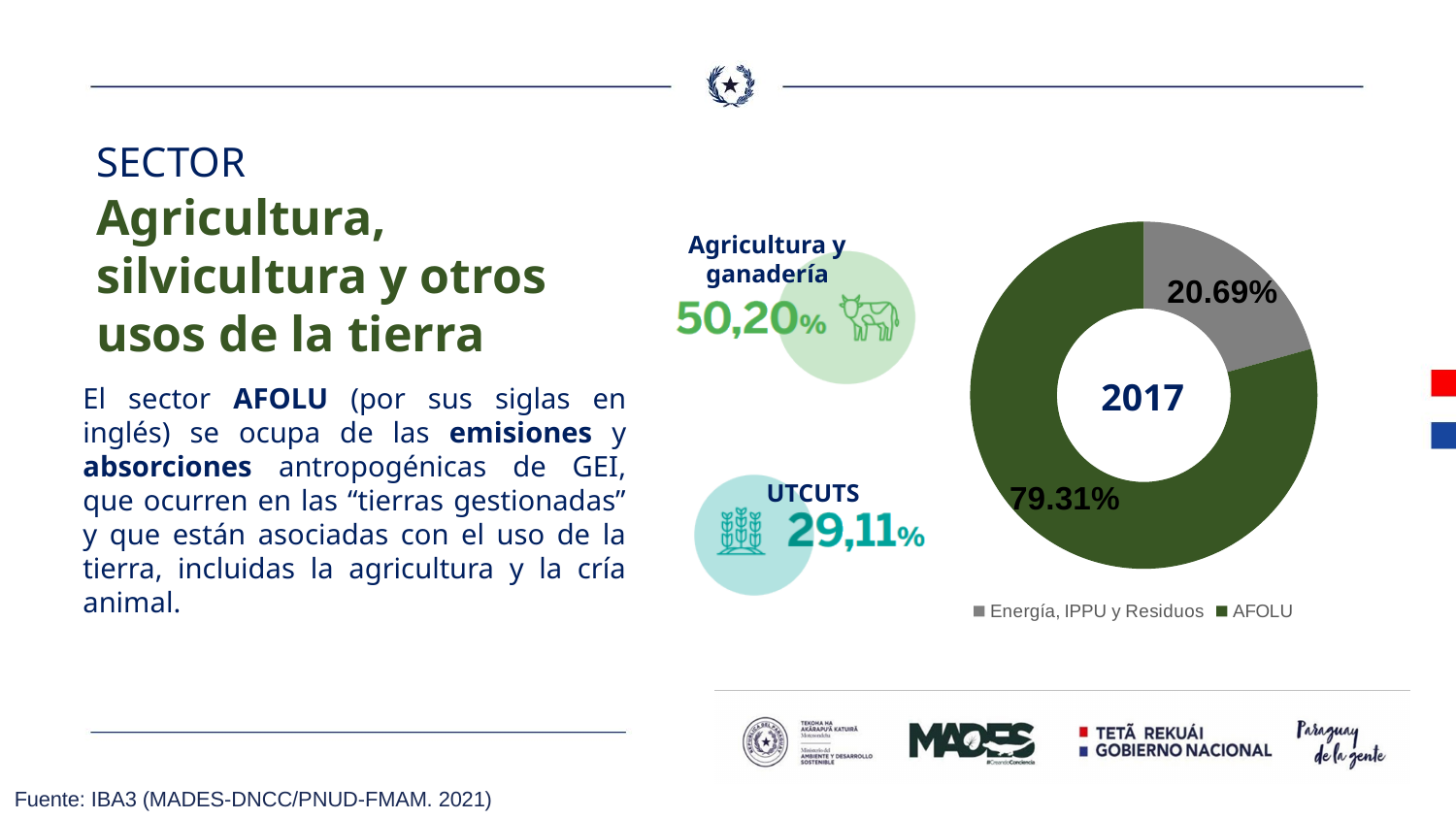
What is the total of the two slices shown in the donut chart? 100% Which category has the smallest share in the donut chart? Energía, IPPU y Residuos What share of the donut chart does Energía, IPPU y Residuos account for? 20.69% Which is larger in the donut chart: AFOLU or Energía, IPPU y Residuos? AFOLU What is the difference in percentage points between the AFOLU share and the Energía, IPPU y Residuos share? 58.62 Which category has the largest share in the donut chart? AFOLU How many categories does the donut chart show? 2 What share of the donut chart does AFOLU account for? 79.31% What kind of chart is shown on the slide? Donut (pie) chart What year is shown in the centre of the donut chart? 2017 How many entries does the chart legend list? 2 What colour is the AFOLU slice in the donut chart? Dark green